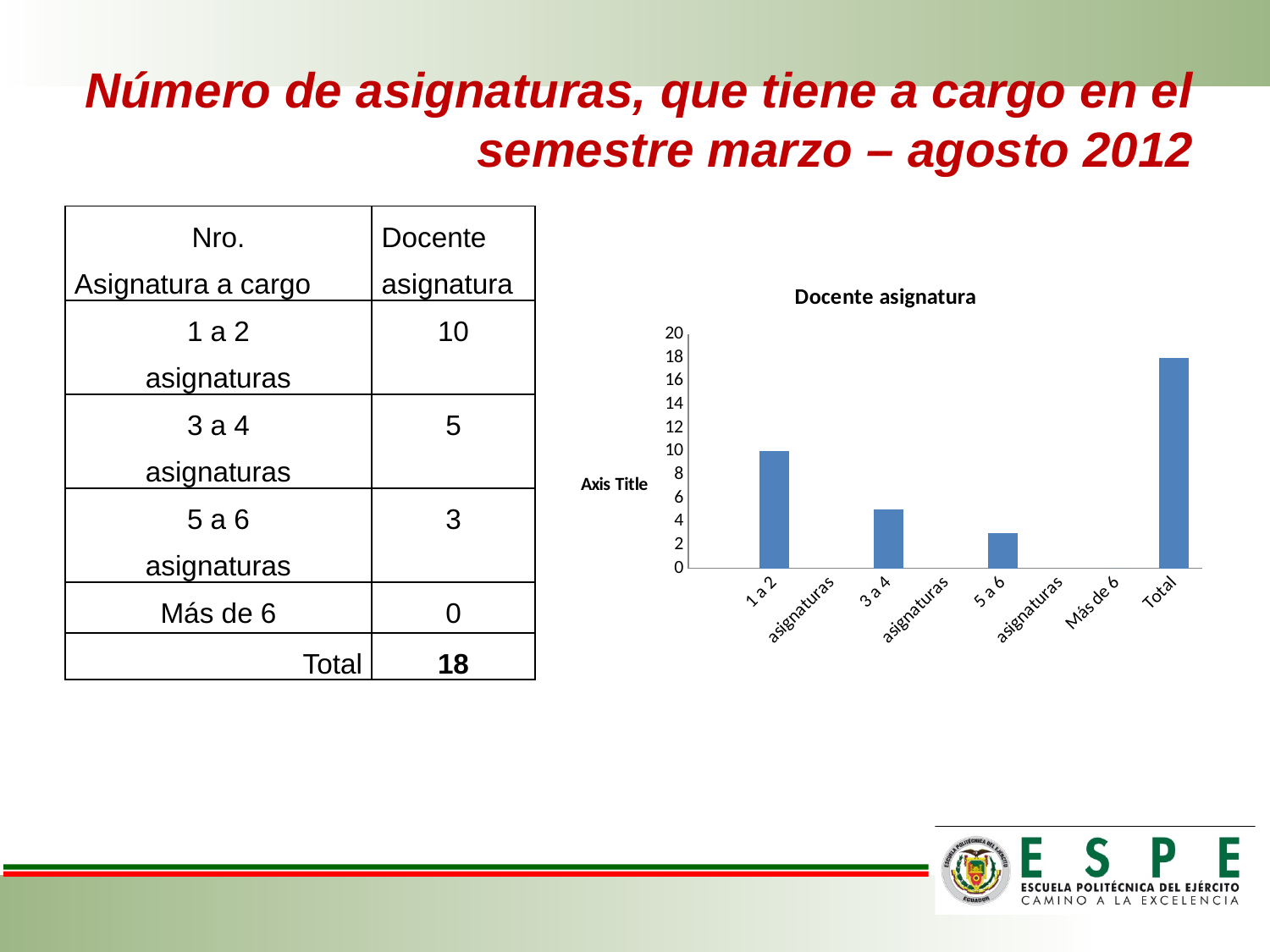
What is the value for '1 a 2 asignaturas' in the chart? 10 Which category has the highest bar in the chart? Total What is the value for 'Total' in the chart? 18 Is the value for '5 a 6 asignaturas' greater or less than 4? less What is the title of the chart? Docente asignatura What is the difference between the value for 'Total' and the value for '1 a 2 asignaturas'? 8 How many categories are shown on the x axis of the chart? 5 Is the value for '3 a 4 asignaturas' greater or less than 4? greater What type of chart is shown on the slide? bar chart Which is larger, the bar for '1 a 2 asignaturas' or the bar for '3 a 4 asignaturas'? 1 a 2 asignaturas Which category has the lowest bar in the chart? Más de 6 What is the value for 'Más de 6' in the chart? 0